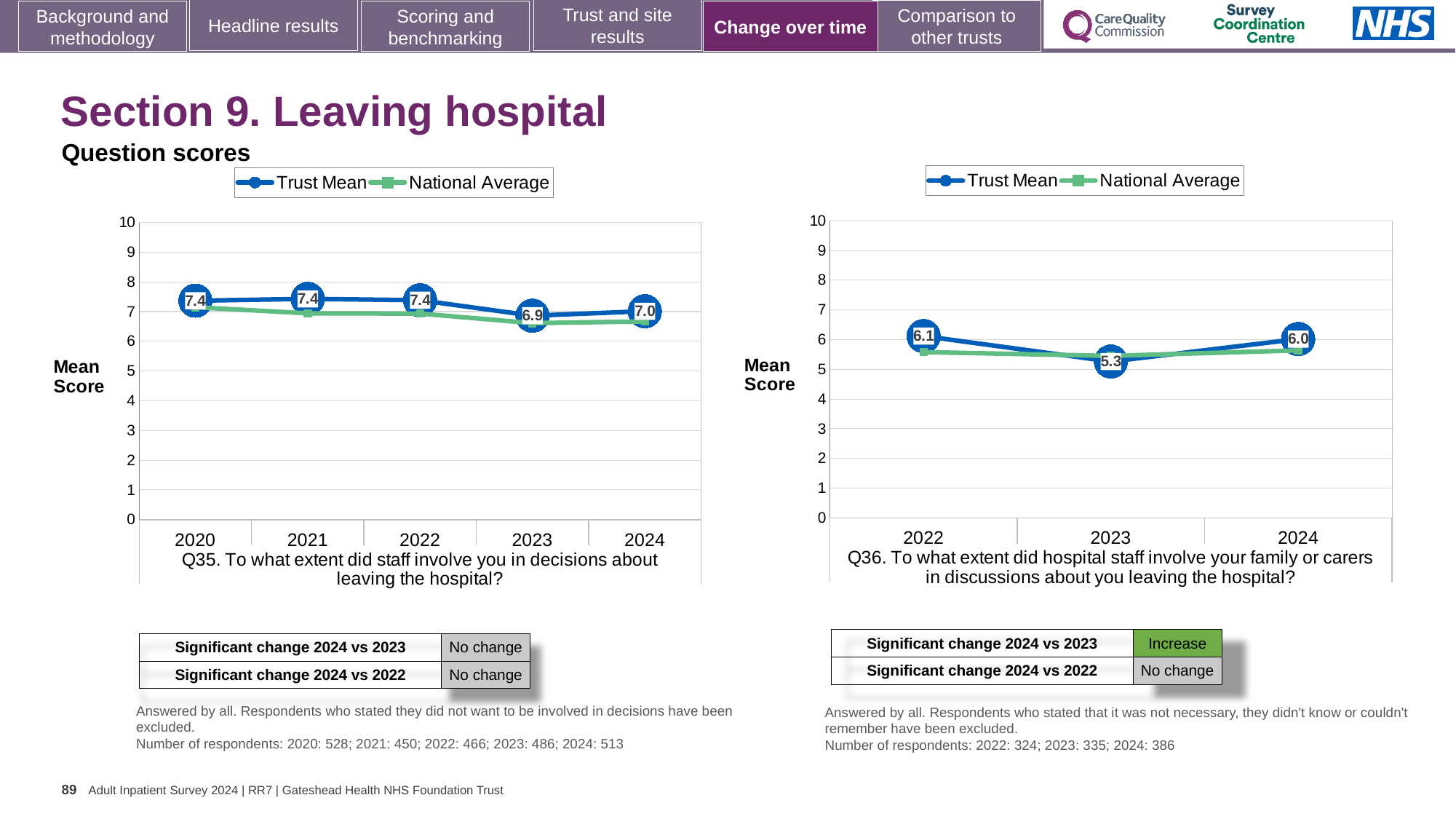
In the Q35 chart (left), which year has the lowest Trust Mean score? 2023 In the Q35 chart (left), what is the difference between the Trust Mean score in 2022 and in 2023? 0.5 In the Q36 chart (right), what is the Trust Mean score for 2022? 6.1 How many years are plotted on the x axis of the Q35 chart (left)? 5 How many series does the legend of the Q36 chart (right) list? 2 In the Q35 chart (left), what is the Trust Mean score for 2024? 7.0 In the Q36 chart (right), what is the Trust Mean score for 2023? 5.3 In the Q35 chart (left), what is the Trust Mean score for 2023? 6.9 In the Q36 chart (right), is the Trust Mean score for 2022 greater or less than 5? greater What type of chart is the Q35 chart (left)? Line chart In the Q36 chart (right), what is the difference between the Trust Mean score in 2024 and in 2023? 0.7 In the Q36 chart (right), which year has the lowest Trust Mean score? 2023